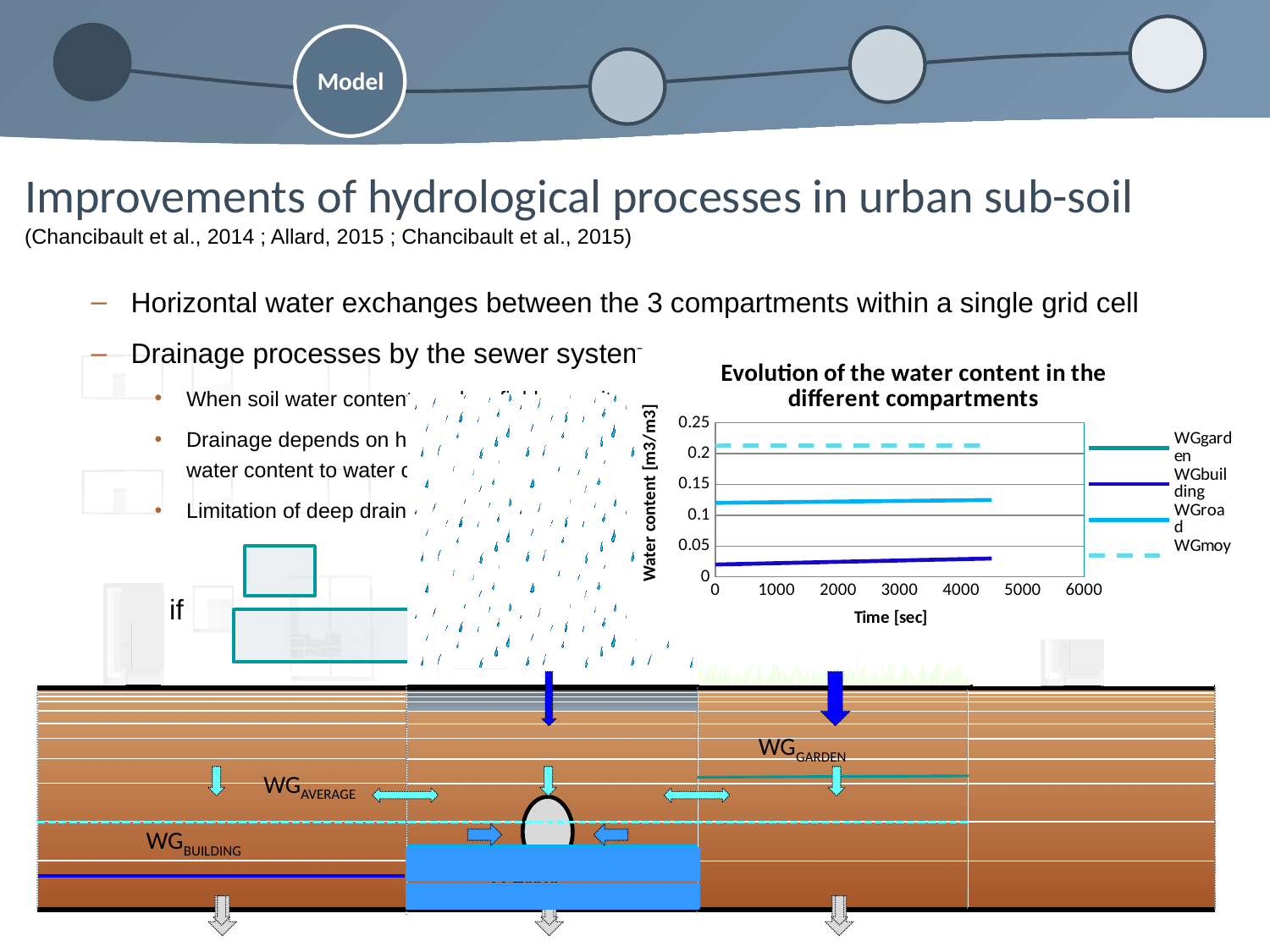
Is the value of the WGroad series greater or less than 0.1? greater What is the title of the chart? Evolution of the water content in the different compartments Is the value of the WGbuilding series greater or less than 0.05? less Does the WGbuilding series rise or fall as time increases? rises What kind of chart is shown on the slide? line chart Is the value of the WGroad series greater or less than 0.15? less Which series has higher values, WGroad or WGbuilding? WGroad Does the WGroad series rise or fall as time increases? rises What is the label of the x axis of the chart? Time [sec] Which series has higher values, WGmoy or WGroad? WGmoy How many series does the legend of the chart list? 4